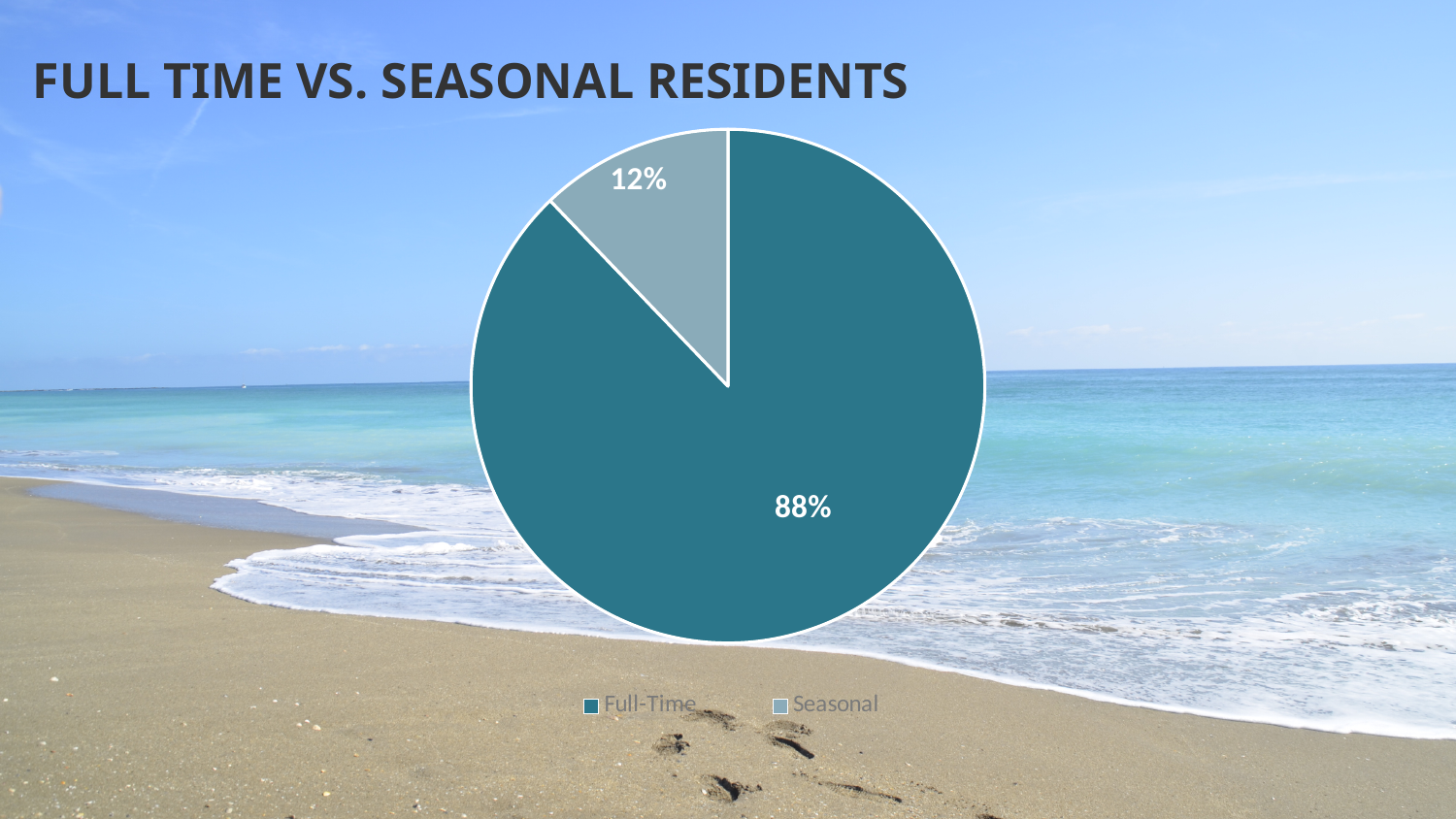
What is the difference in percentage points between the Full-Time and Seasonal slices? 76 How many entries does the legend list? 2 What share of the pie is Full-Time? 88% Which legend entry is shown in the lighter grey-blue colour? Seasonal Which category has the largest slice of the pie? Full-Time Which is larger, the Full-Time slice or the Seasonal slice? Full-Time Which category has the smallest slice of the pie? Seasonal How many slices does the pie chart have? 2 What kind of chart is shown on the slide? Pie chart What is the title of the slide containing the chart? FULL TIME VS. SEASONAL RESIDENTS What share of the pie is Seasonal? 12%